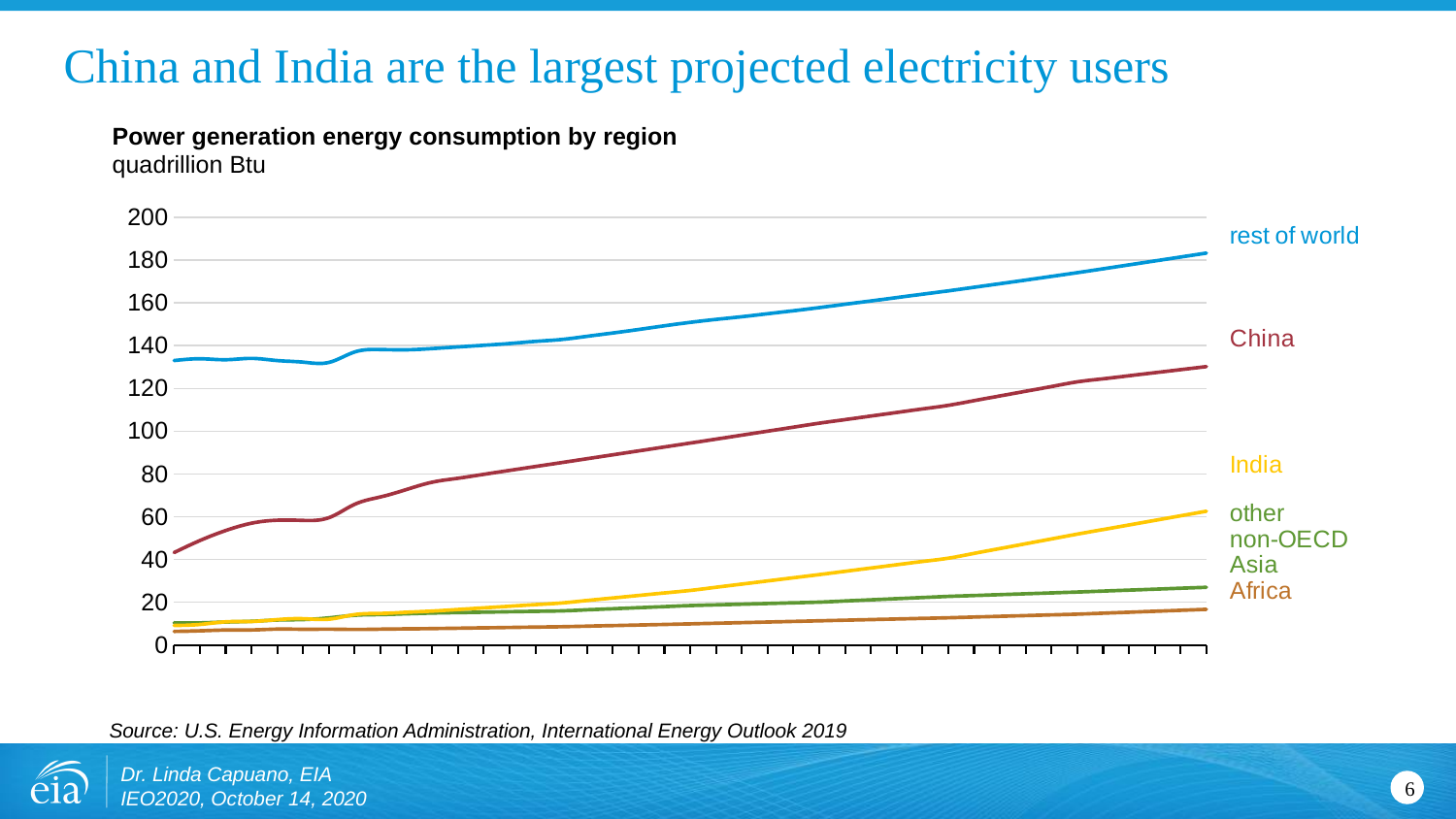
At the right end of the chart, which is larger: China or India? China Is the value for Africa at the right end of the chart greater or less than 20? less Does the line for India rise or fall from left to right? rise Which region has the lowest power generation energy consumption across the chart? Africa Which region has the highest power generation energy consumption at the right end of the chart? rest of world Is the value for rest of world at the right end of the chart greater or less than 160? greater What kind of chart is shown on the slide? line chart How many series (regions) are plotted on the chart? 5 Is the value for India at the right end of the chart greater or less than 40? greater At the right end of the chart, which is larger: other non-OECD Asia or Africa? other non-OECD Asia Does the line for China rise or fall from left to right? rise What unit is the chart's y axis measured in? quadrillion Btu